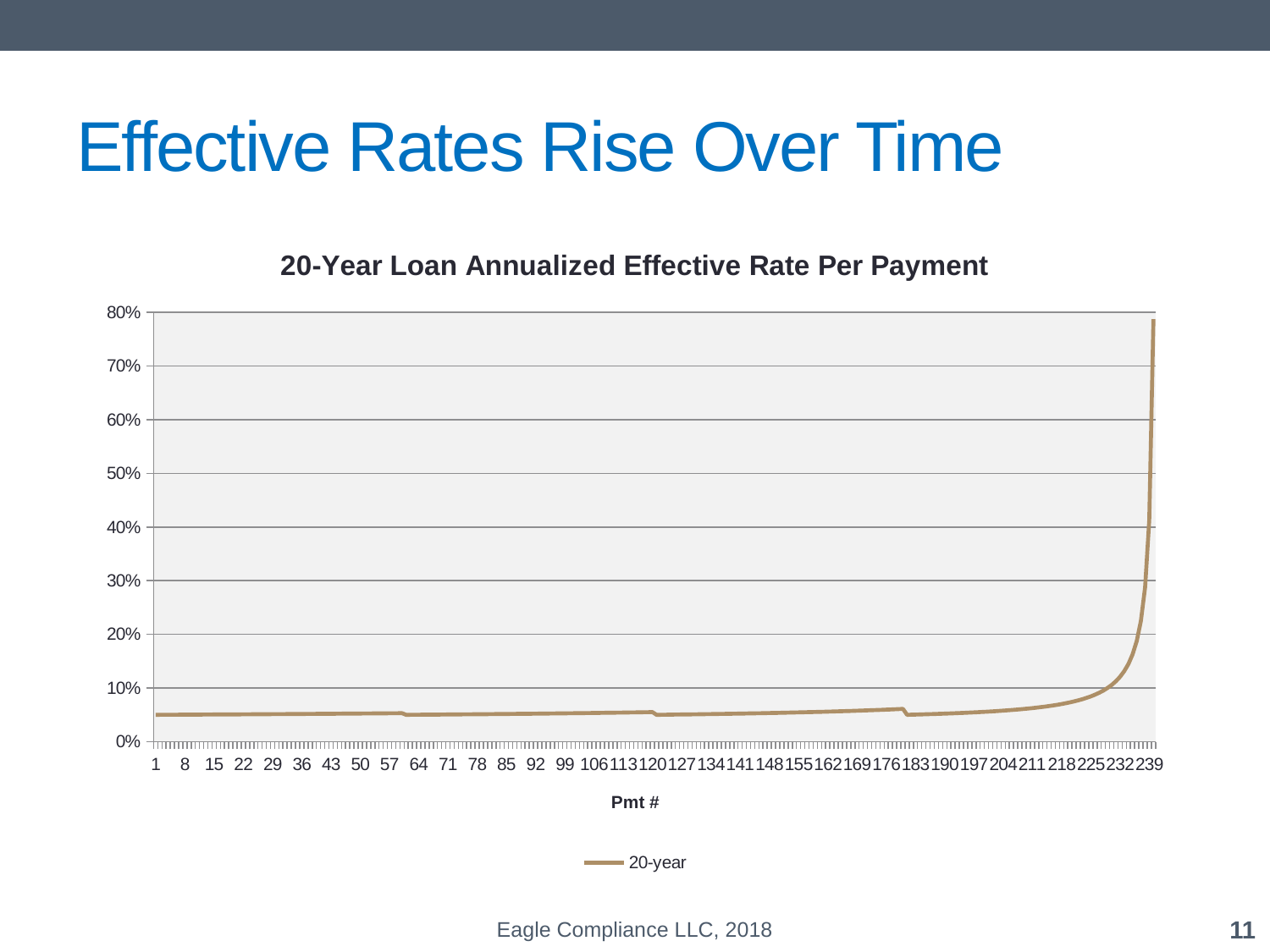
How many series does the legend list? 1 Does the annualized effective rate rise or fall as the payment number increases along the x axis? rise What is the title of the chart? 20-Year Loan Annualized Effective Rate Per Payment What kind of chart is shown on the slide? line chart Is the value for Pmt # 232 greater or less than 30%? less Which is larger, the value at Pmt # 232 or the value at Pmt # 50? Pmt # 232 Is the value for Pmt # 120 greater or less than 10%? less What is the label of the x axis? Pmt # Is the value for Pmt # 1 greater or less than 10%? less Which is larger, the value at Pmt # 239 or the value at Pmt # 1? Pmt # 239